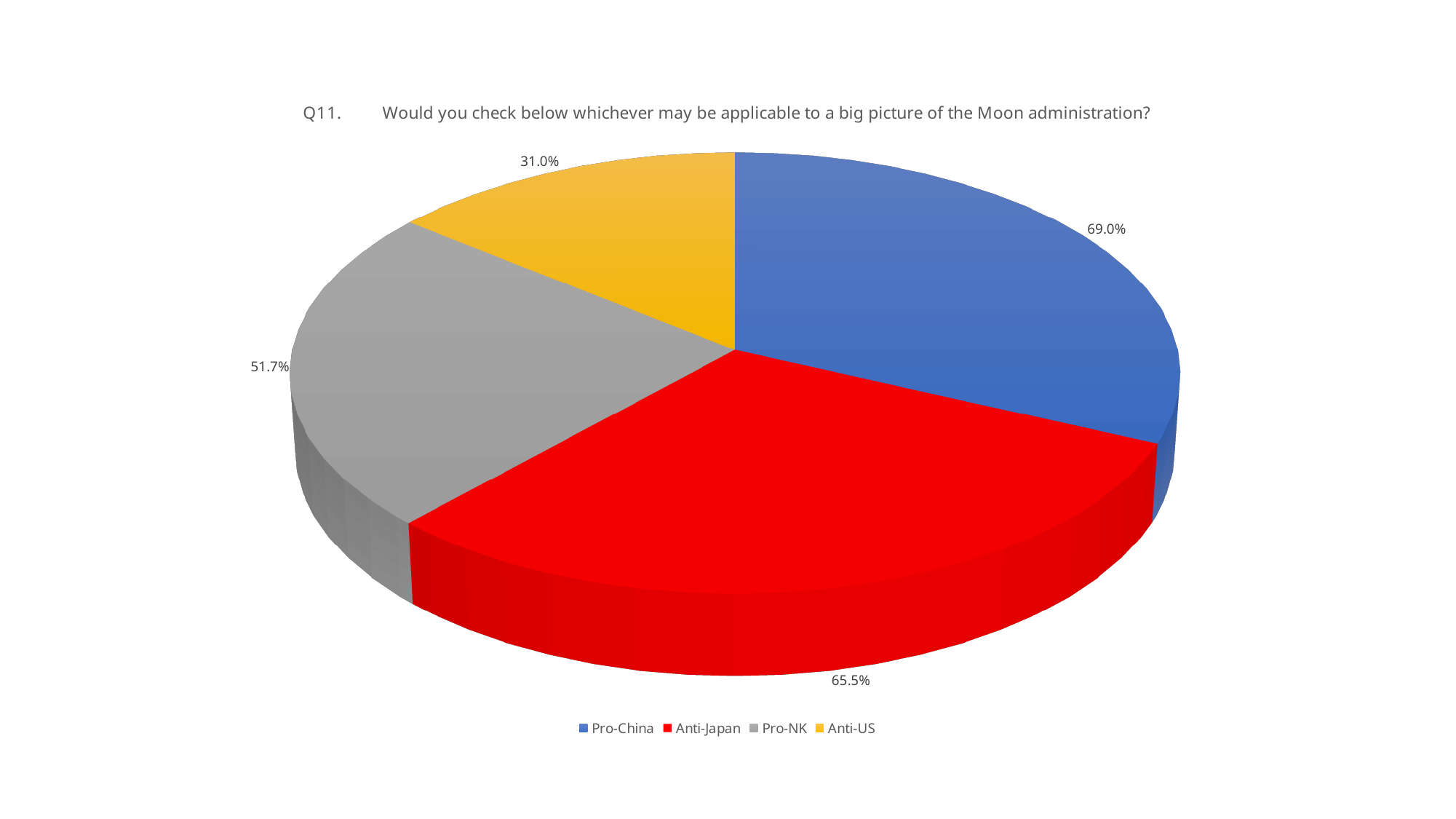
What kind of chart is shown on the slide? Pie chart What is the value labelled for the Pro-NK slice? 51.7% What is the difference between the Pro-NK value and the Anti-US value? 20.7 percentage points Which category has the highest labelled value? Pro-China What is the value labelled for the Pro-China slice? 69.0% What colour is the Anti-US slice? Yellow What is the value labelled for the Anti-Japan slice? 65.5% What is the difference between the Pro-China value and the Anti-Japan value? 3.5 percentage points Which category has the lowest labelled value? Anti-US What is the value labelled for the Anti-US slice? 31.0% Which is larger, the Anti-Japan value or the Pro-NK value? Anti-Japan How many categories does the legend list? 4